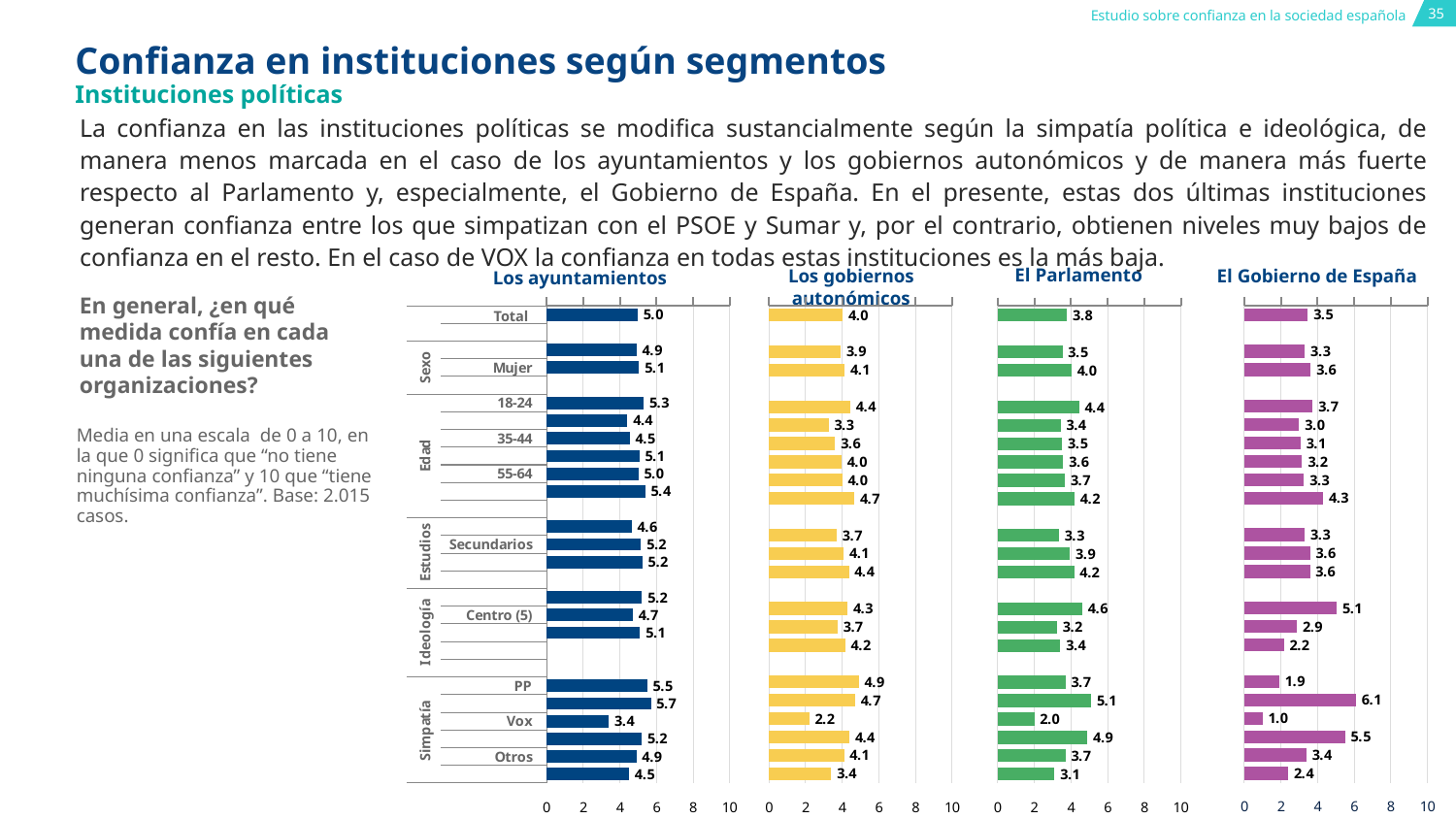
In the 'El Gobierno de España' chart, what is the value for Centro (5)? 2.9 In the 'Los gobiernos autonómicos' chart, what is the value for Mujer? 4.1 In the 'Los gobiernos autonómicos' chart, which is larger, the value for PP or the value for Otros? PP How many charts are shown on the slide? 4 In the 'El Parlamento' chart, is the value for 18-24 greater or less than 4? greater In the 'El Parlamento' chart, which category has the lowest value? Vox In the 'El Parlamento' chart, what is the value for PP? 3.7 In the 'El Gobierno de España' chart, what is the difference between the values for Total and PP? 1.6 In the 'Los ayuntamientos' chart, what is the value for Total? 5.0 In the 'Los ayuntamientos' chart, what is the difference between the values for PP and Vox? 2.1 What type of chart is used on this slide? Bar chart In the 'El Gobierno de España' chart, what is the value for Vox? 1.0